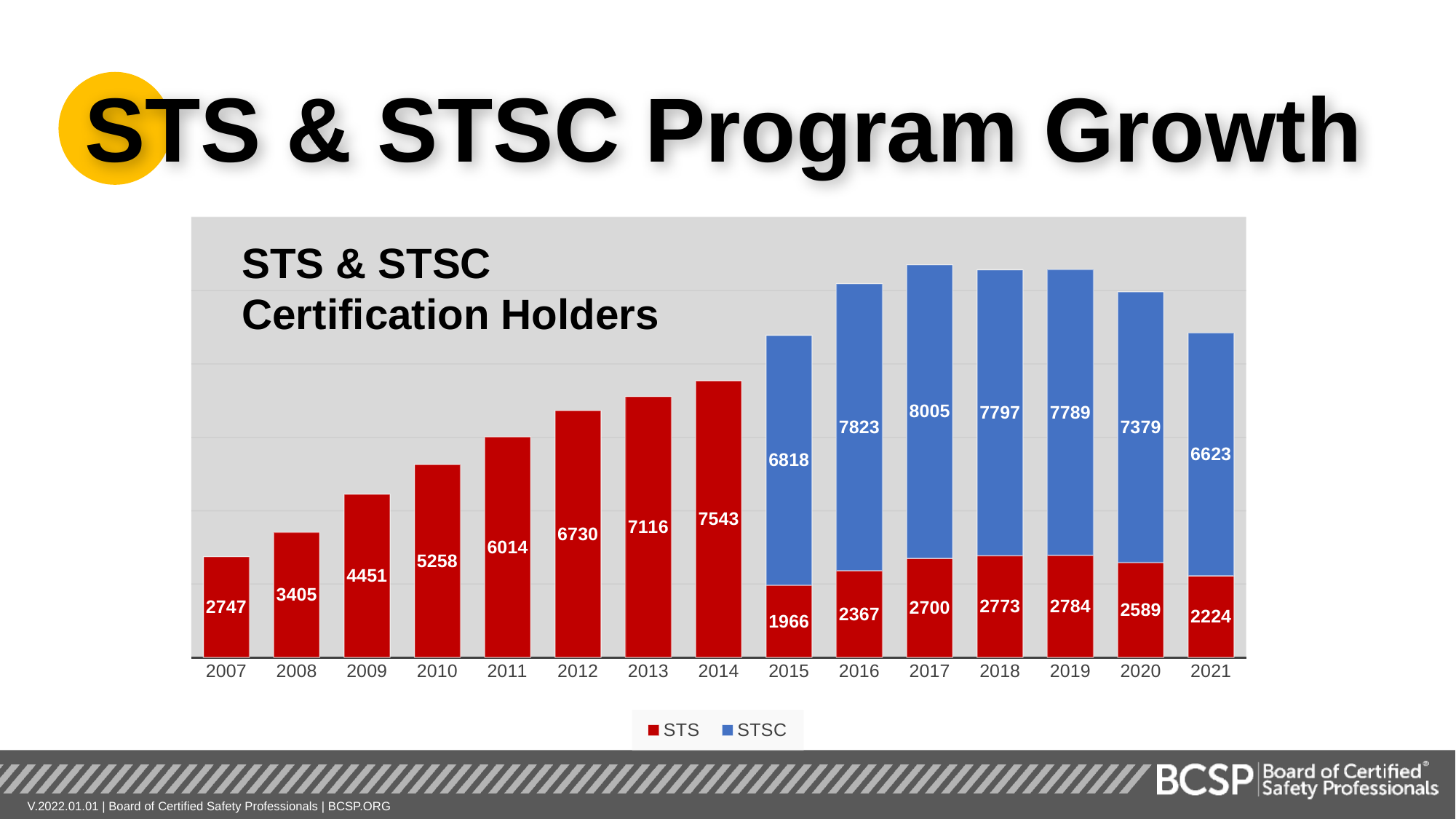
How many years are shown on the x axis? 15 Which year has the lowest STS value? 2015 What is the total of the stacked bar for 2017? 10705 What is the STSC value for 2018? 7797 What is the STS value for 2010? 5258 What is the difference between the STS value in 2014 and the STS value in 2007? 4796 Which year has the highest STSC value? 2017 Which is larger, the STSC value in 2016 or the STSC value in 2020? 2016 Do the STS values rise or fall from 2007 to 2014? Rise What kind of chart is shown? Stacked bar chart Which year has the highest STS value? 2014 How many series does the legend list? 2